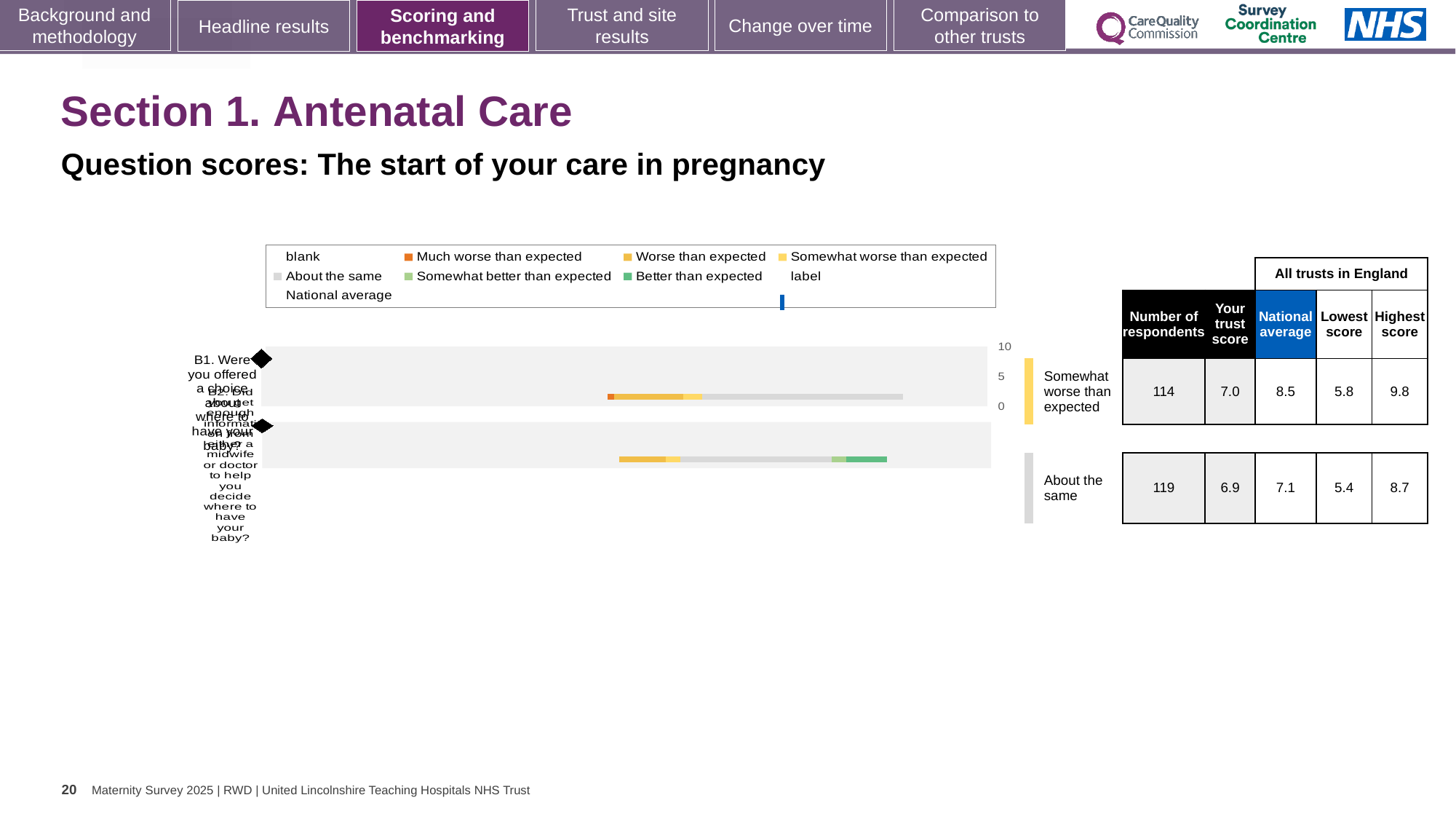
What is the highest score across all trusts in England for B2? 8.7 What kind of chart is shown on the slide? Bar chart What is the difference between the highest and lowest scores for B2? 3.3 Which question has the higher trust score, B1 or B2? B1 How many respondents answered B1? 114 What is the national average for B2 (Did you get enough information to help you decide where to have your baby?)? 7.1 Which benchmark category is B1 placed in? Somewhat worse than expected What colour represents 'Much worse than expected' in the legend? Orange What is the trust score for B1 (Were you offered a choice about where to have your baby?)? 7.0 How many questions (categories) are plotted in the chart? 2 What is the lowest score across all trusts in England for B1? 5.8 By how much is the national average higher than the trust score for B1? 1.5